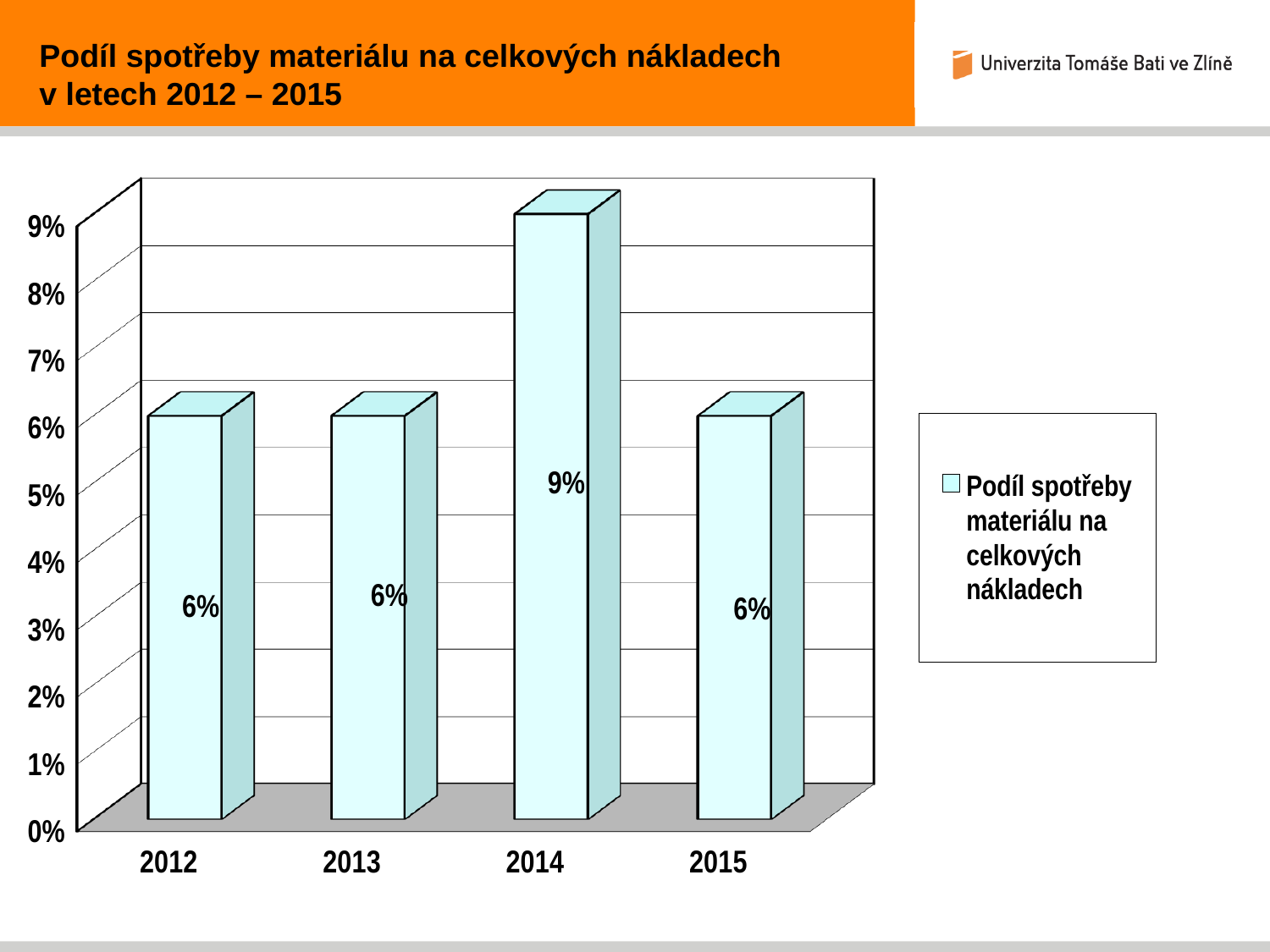
What is the value for 2015? 6% What is the value for 2014? 9% Is the value for 2013 greater or less than 7%? less Which is larger, the value for 2014 or the value for 2015? 2014 Which year has the highest share of material consumption in total costs? 2014 What kind of chart is shown on the slide? bar chart Is the value for 2014 greater or less than 8%? greater What is the difference between the values for 2014 and 2013? 3% What is the value for 2012? 6% What is the legend entry for the series shown? Podíl spotřeby materiálu na celkových nákladech How many years are shown on the x axis? 4 How many series does the legend list? 1